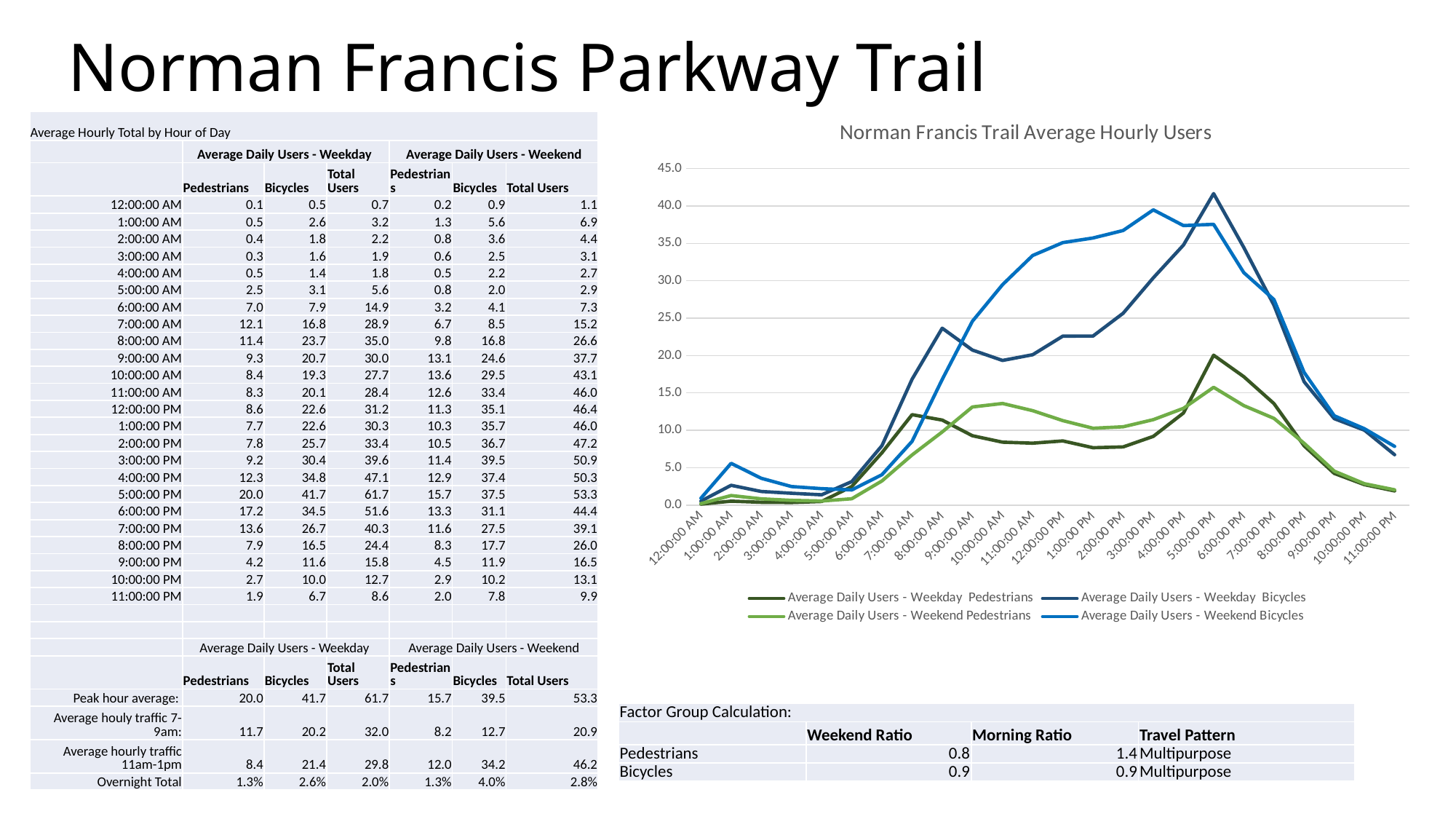
In the 'Norman Francis Trail Average Hourly Users' chart, at 5:00:00 PM which is larger: Weekday Pedestrians or Weekend Pedestrians? Weekday Pedestrians In the 'Norman Francis Trail Average Hourly Users' chart, is the value for Weekend Bicycles at 3:00:00 PM greater or less than 35? greater In the 'Norman Francis Trail Average Hourly Users' chart, is the value for Weekend Pedestrians at 10:00:00 AM greater or less than 15? less In the 'Norman Francis Trail Average Hourly Users' chart, at 10:00:00 AM which is larger: Weekday Bicycles or Weekend Bicycles? Weekend Bicycles How many hourly points are plotted along the x axis of the 'Norman Francis Trail Average Hourly Users' chart? 24 What is the title of the line chart on the slide? Norman Francis Trail Average Hourly Users What is the highest value shown on the y axis of the 'Norman Francis Trail Average Hourly Users' chart? 45.0 How many series does the legend of the 'Norman Francis Trail Average Hourly Users' chart list? 4 What kind of chart is 'Norman Francis Trail Average Hourly Users'? line chart In the 'Norman Francis Trail Average Hourly Users' chart, which series reaches the highest value? Average Daily Users - Weekday Bicycles In the 'Norman Francis Trail Average Hourly Users' chart, do the Weekday Bicycles values rise or fall from 5:00:00 PM to 11:00:00 PM? fall In the 'Norman Francis Trail Average Hourly Users' chart, is the value for Weekday Bicycles at 5:00:00 PM greater or less than 40? greater